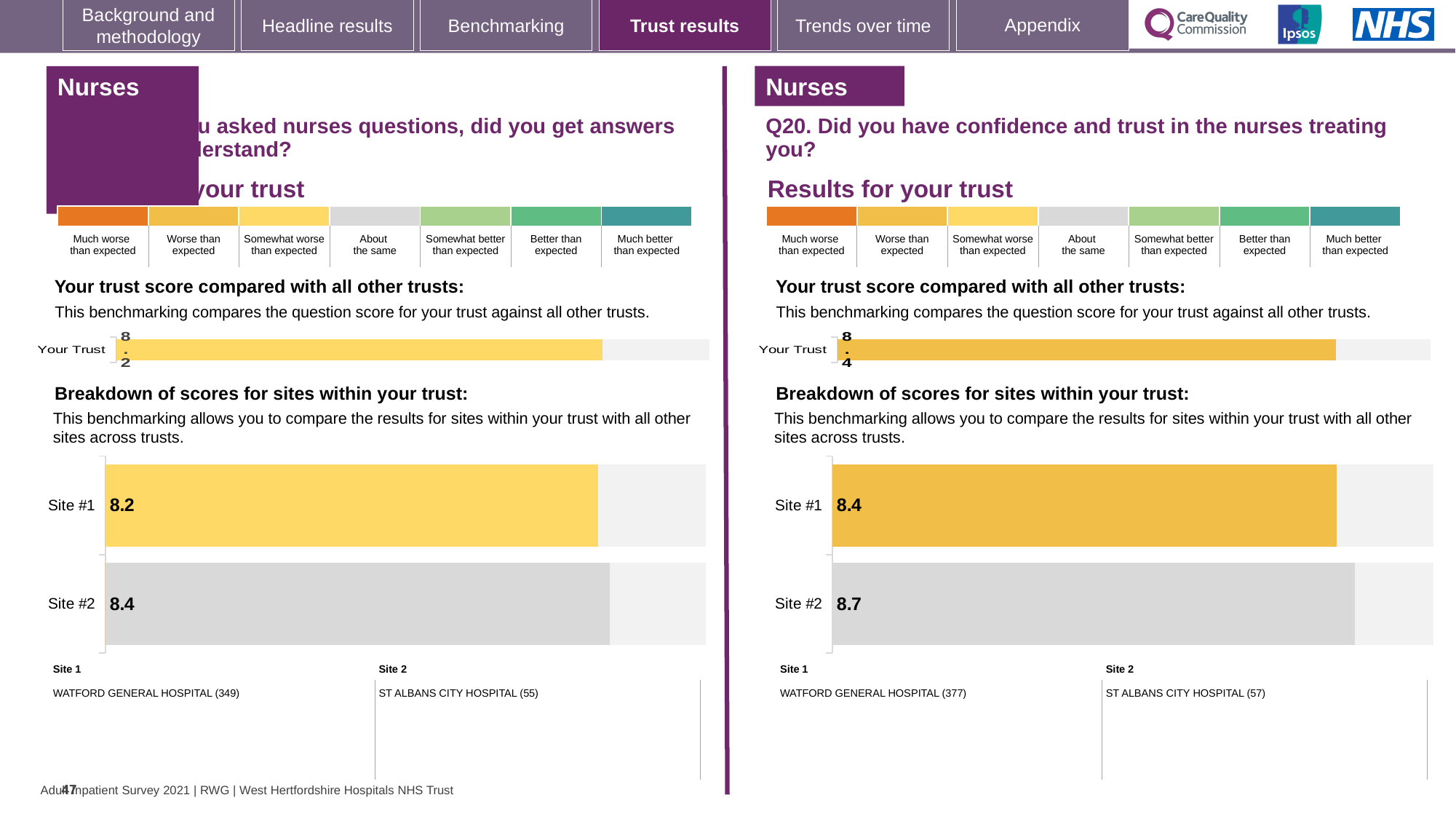
On the right-hand Q20 site breakdown chart, what is the score for Site #2? 8.7 On the left-hand site breakdown chart, what is the score for Site #1? 8.2 On the left-hand site breakdown chart, what is the difference between the Site #2 and Site #1 scores? 0.2 How many sites are shown on the right-hand Q20 site breakdown chart? 2 On the right-hand Q20 'Your trust score compared with all other trusts' chart, what is the value for Your Trust? 8.4 What type of chart is used for the site breakdown on the left-hand side of the slide? Bar chart On the left-hand 'Your trust score compared with all other trusts' chart, what is the value for Your Trust? 8.2 On the right-hand Q20 site breakdown chart, what is the score for Site #1? 8.4 On the left-hand site breakdown chart, which site has the lower score? Site #1 On the right-hand Q20 site breakdown chart, which site has the higher score? Site #2 On the left-hand site breakdown chart, what is the score for Site #2? 8.4 On the right-hand Q20 site breakdown chart, what is the difference between the Site #2 and Site #1 scores? 0.3